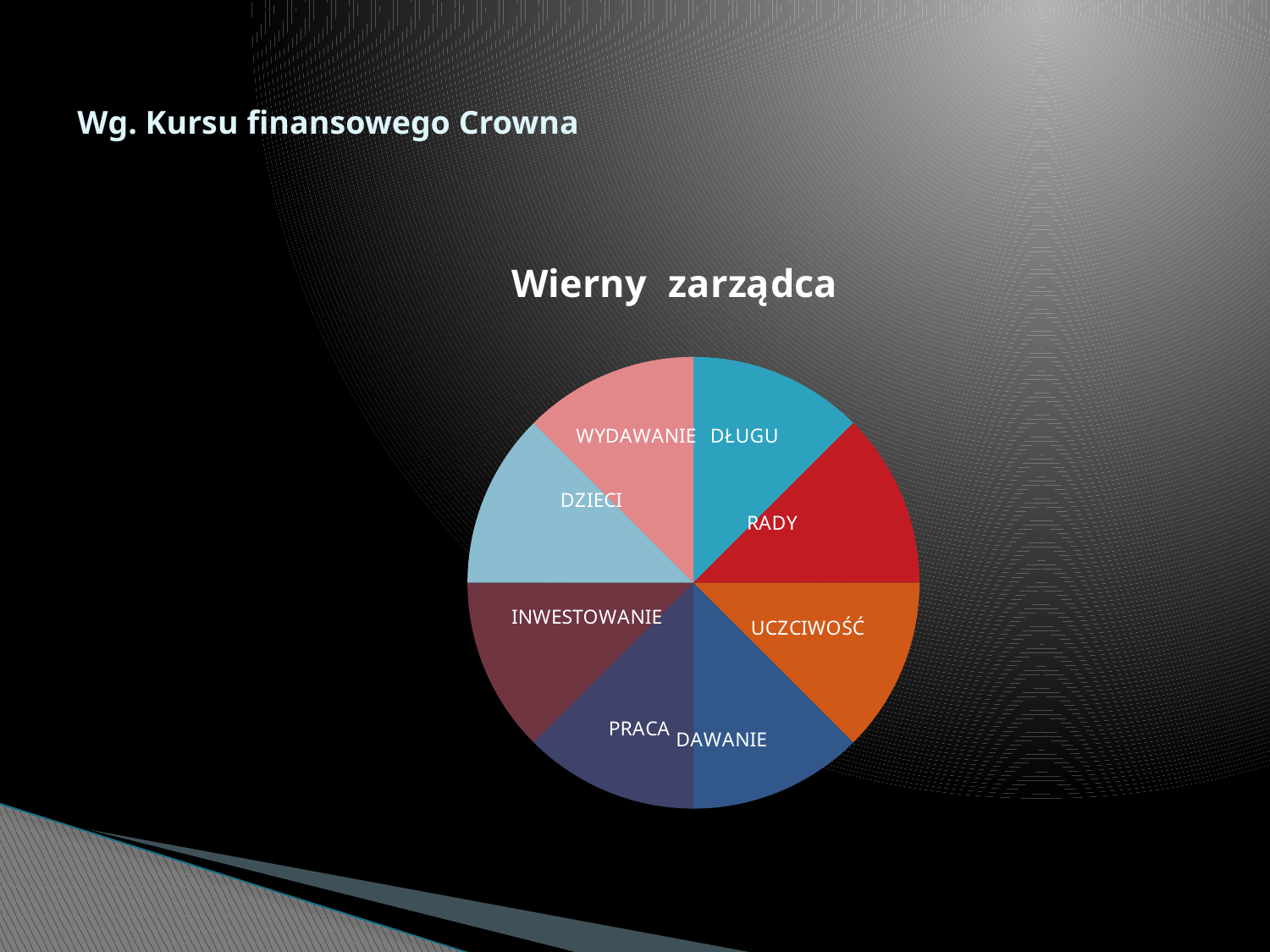
Which slice of the pie chart lies between DŁUGU and UCZCIWOŚĆ? RADY Which slice of the pie chart lies between DZIECI and PRACA? INWESTOWANIE Which slice of the pie chart is coloured orange? UCZCIWOŚĆ Which slice of the pie chart lies between WYDAWANIE and INWESTOWANIE? DZIECI Which slice of the pie chart lies between UCZCIWOŚĆ and PRACA? DAWANIE How many slices does the pie chart have? 8 What is the title of the pie chart? Wierny zarządca Which slice of the pie chart is directly to the left of DŁUGU at the top of the pie? WYDAWANIE What kind of chart is shown on the slide? pie chart